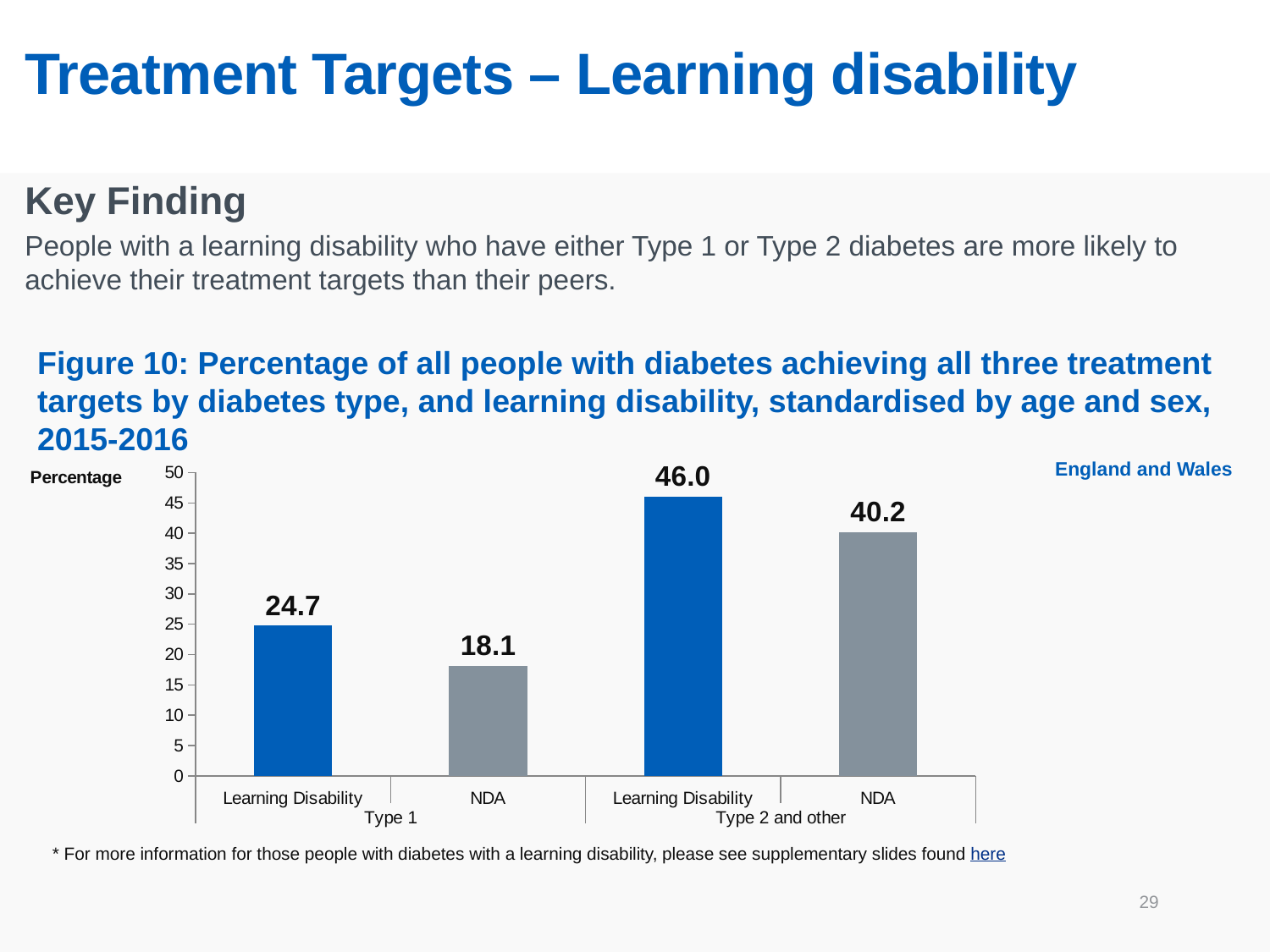
Which bar has the lowest value? NDA, Type 1 What is the difference between the Learning Disability and NDA values in the Type 1 group? 6.6 What is the difference between the Learning Disability and NDA values in the Type 2 and other group? 5.8 What is the value for NDA in the Type 1 group? 18.1 Which bar has the highest value? Learning Disability, Type 2 and other What is the value for Learning Disability in the Type 1 group? 24.7 What is the label on the vertical axis of the chart? Percentage What is the value for NDA in the Type 2 and other group? 40.2 What kind of chart is shown? Bar chart What is the value for Learning Disability in the Type 2 and other group? 46.0 Which is larger in the Type 2 and other group: Learning Disability or NDA? Learning Disability How many bars are plotted in the chart? 4